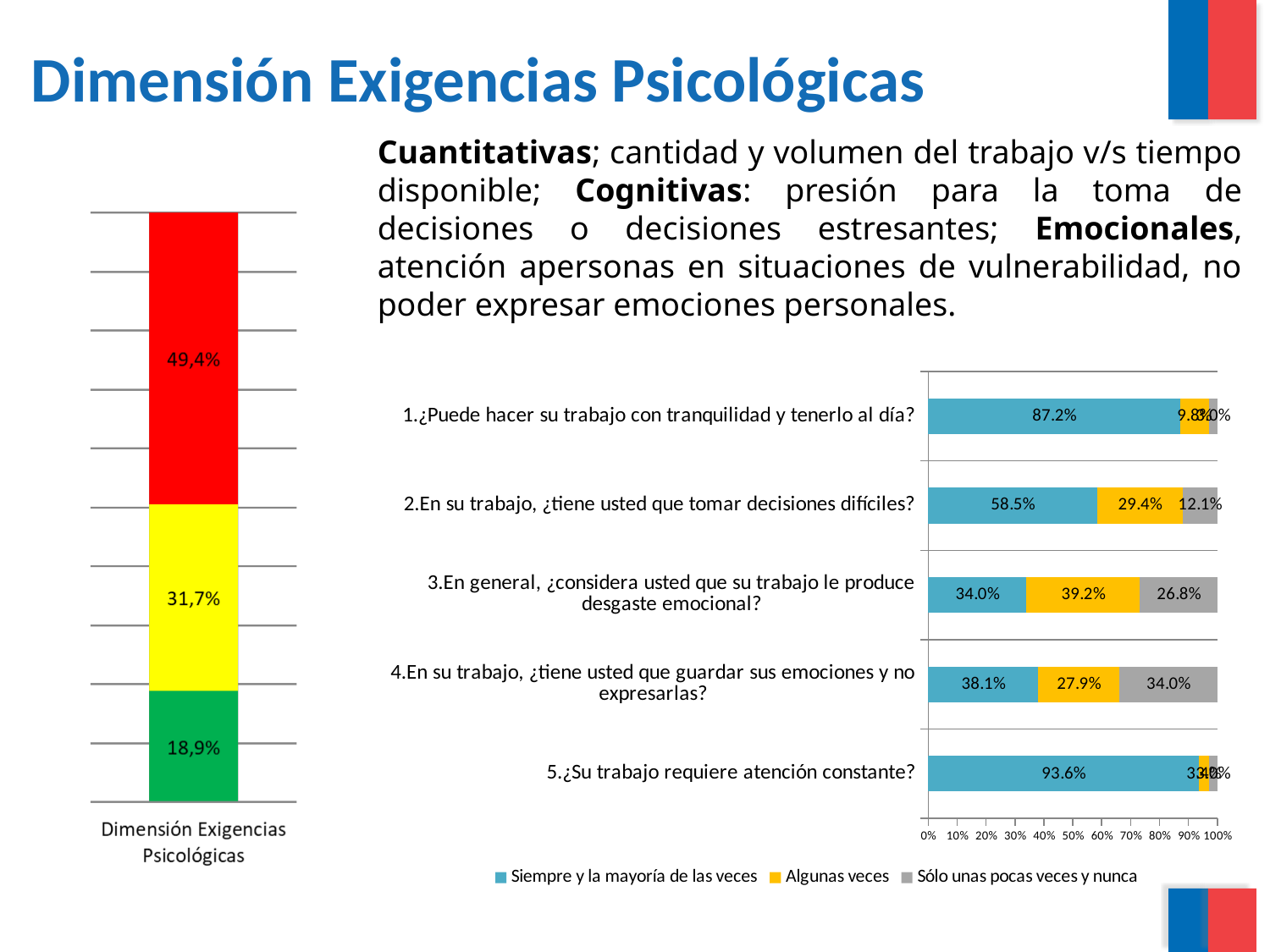
In the left chart titled 'Dimensión Exigencias Psicológicas', what value is shown on the red segment? 49,4% In the left chart titled 'Dimensión Exigencias Psicológicas', which colour segment has the largest value? Red In the left chart titled 'Dimensión Exigencias Psicológicas', what value is shown on the yellow segment? 31,7% In the right chart, what is the 'Sólo unas pocas veces y nunca' value for '4.En su trabajo, ¿tiene usted que guardar sus emociones y no expresarlas?'? 34.0% In the right chart, what is the 'Siempre y la mayoría de las veces' value for '5.¿Su trabajo requiere atención constante?'? 93.6% In the right chart, what is the 'Algunas veces' value for '3.En general, ¿considera usted que su trabajo le produce desgaste emocional?'? 39.2% In the right chart, how many series does the legend list? 3 In the right chart, what is the 'Siempre y la mayoría de las veces' value for '2.En su trabajo, ¿tiene usted que tomar decisiones difíciles?'? 58.5% In the right chart, what is the difference between the 'Siempre y la mayoría de las veces' values for question 2 and question 3? 24.5% In the left chart titled 'Dimensión Exigencias Psicológicas', what value is shown on the green segment? 18,9% In the right chart, how many questions (categories) are plotted? 5 What kind of chart is the right chart? Stacked bar chart